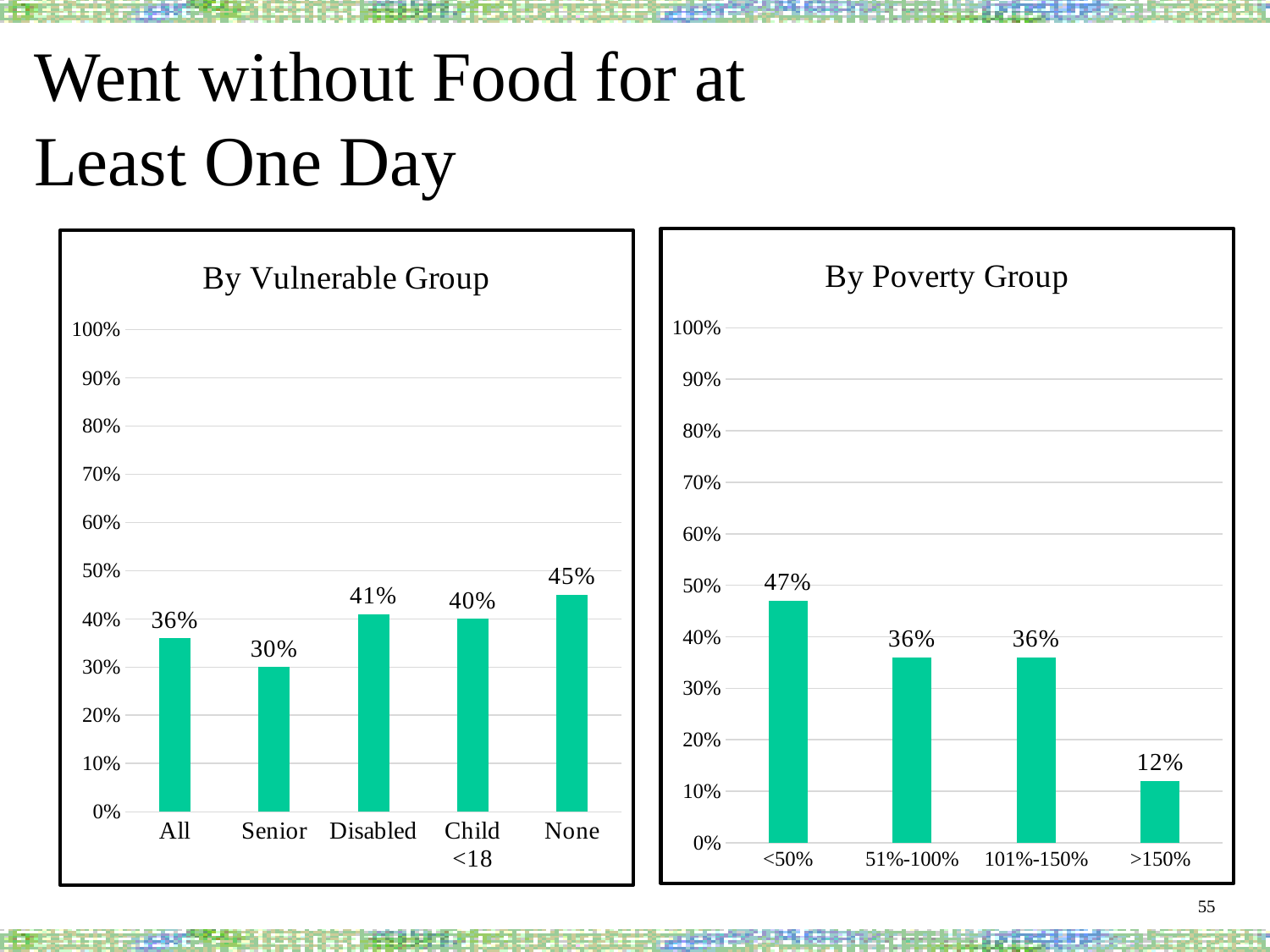
In the 'By Poverty Group' chart, what is the difference between the values for <50% and >150%? 35% In the 'By Vulnerable Group' chart, what is the value for Senior? 30% In the 'By Poverty Group' chart, what is the value for <50%? 47% In the 'By Vulnerable Group' chart, which category has the highest value? None In the 'By Poverty Group' chart, do the values rise or fall from left to right along the x axis? fall In the 'By Vulnerable Group' chart, what is the difference between the values for None and All? 9% In the 'By Poverty Group' chart, which category has the lowest value? >150% In the 'By Vulnerable Group' chart, how many categories are shown? 5 In the 'By Vulnerable Group' chart, which category has the lowest value? Senior In the 'By Vulnerable Group' chart, what is the value for Disabled? 41% In the 'By Poverty Group' chart, what is the value for >150%? 12% What kind of chart is the 'By Poverty Group' chart? bar chart